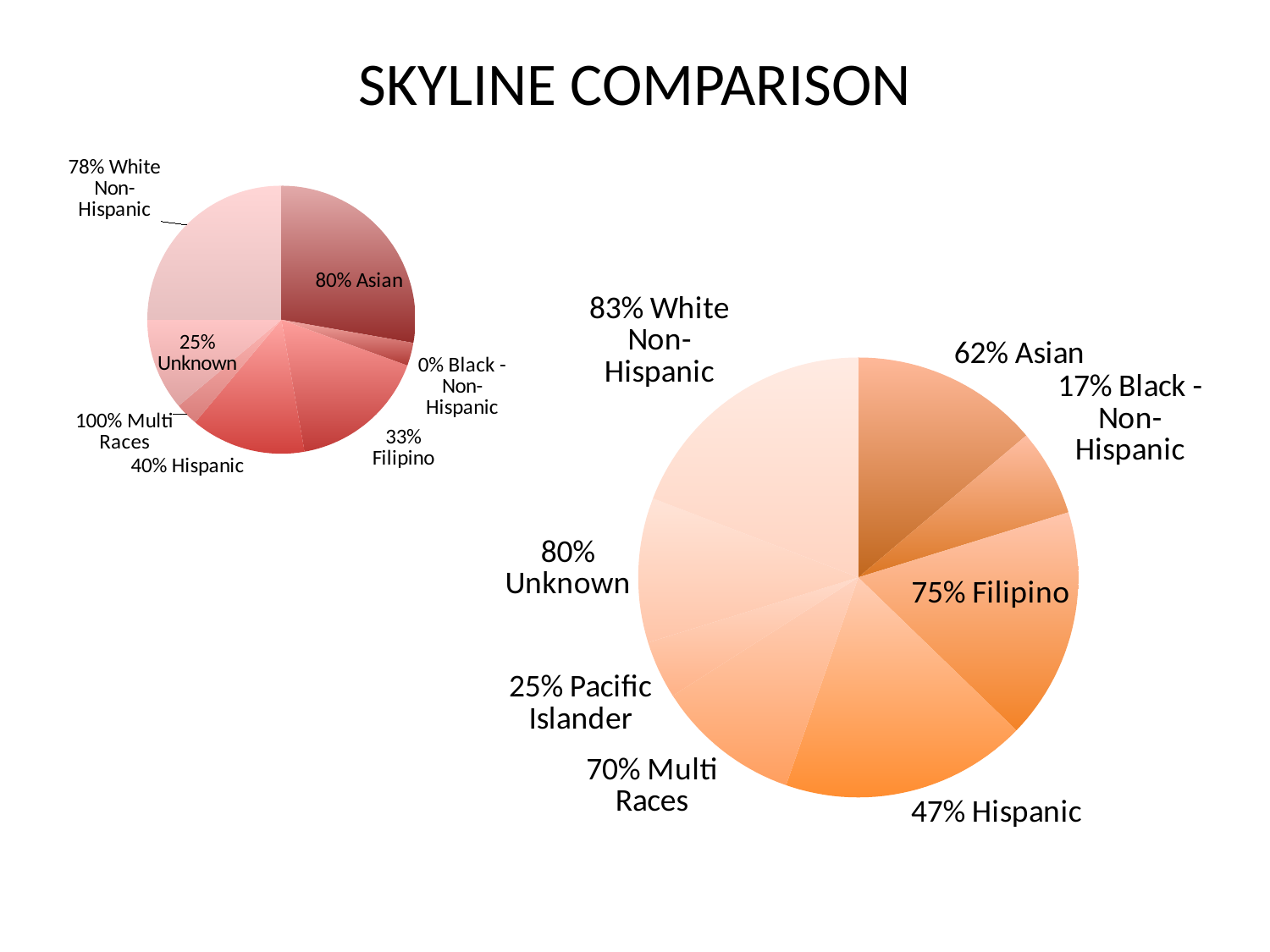
In the small pie chart on the left, what percentage is printed for Hispanic? 40% How many labelled slices does the large pie chart on the right have? 8 In the large pie chart on the right, which category has the highest printed percentage? White Non-Hispanic What is the title of the slide? SKYLINE COMPARISON In the small pie chart on the left, what percentage is printed for Asian? 80% In the large pie chart on the right, what percentage is printed for Pacific Islander? 25% In the small pie chart on the left, which category has the highest printed percentage? Multi Races In the large pie chart on the right, what percentage is printed for Filipino? 75% What kind of chart is the large chart on the right of the slide? pie chart In the small pie chart on the left, which category has the lowest printed percentage? Black - Non-Hispanic In the large pie chart on the right, which category has the lowest printed percentage? Black - Non-Hispanic Which chart shows a higher printed percentage for Filipino, the small pie on the left or the large pie on the right? the large pie on the right